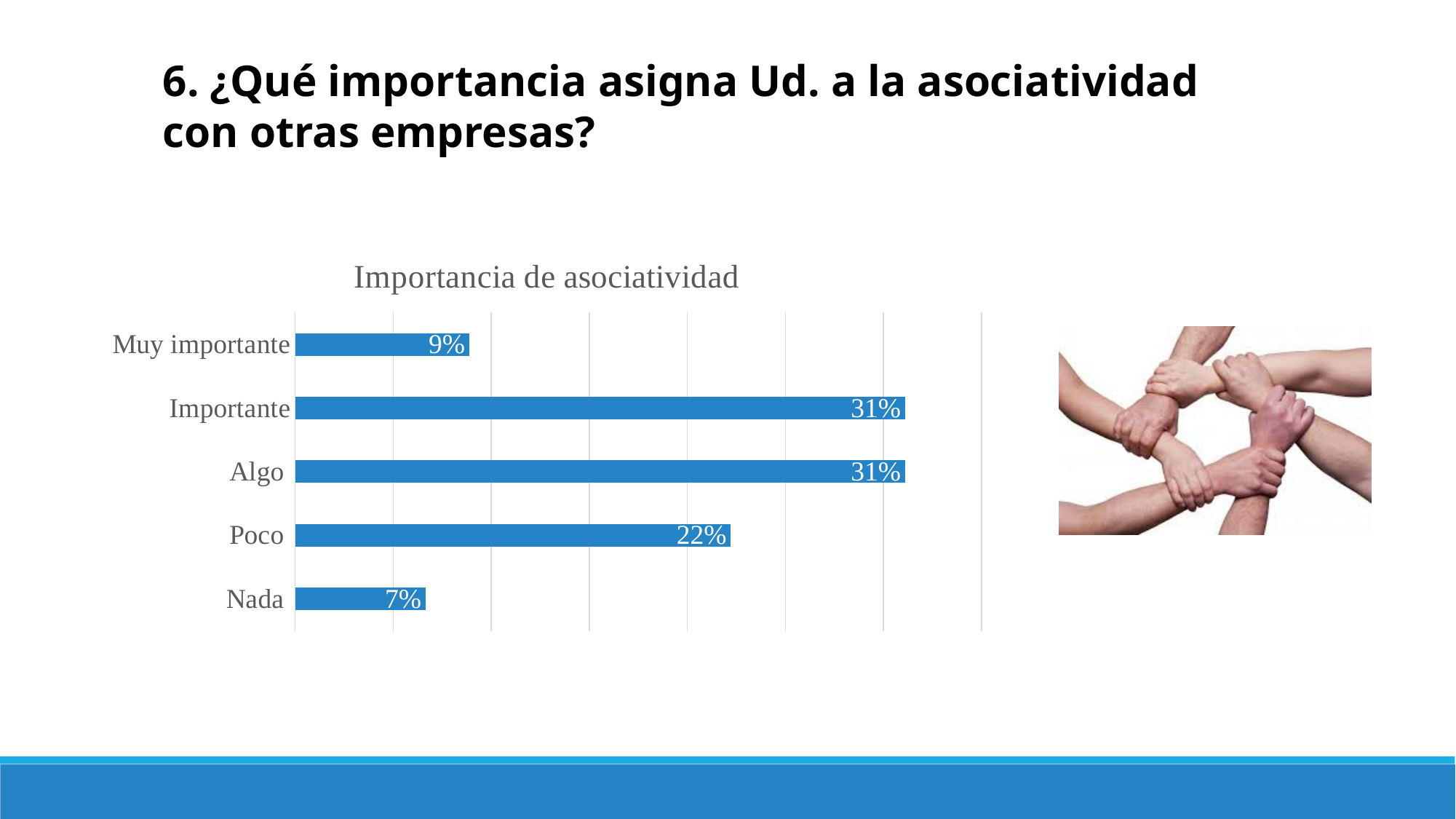
What is the value for "Poco" in the chart? 22% What kind of chart is shown on the slide? Bar chart What is the value for "Nada" in the chart? 7% What is the difference between the values for "Importante" and "Muy importante"? 22% Which is larger, the value for "Algo" or the value for "Poco"? Algo What is the value for "Importante" in the chart? 31% Which is larger, the value for "Poco" or the value for "Muy importante"? Poco What is the title of the chart? Importancia de asociatividad What is the value for "Muy importante" in the chart? 9% What is the difference between the values for "Poco" and "Nada"? 15% How many categories are shown in the chart? 5 Which category has the lowest value in the chart? Nada